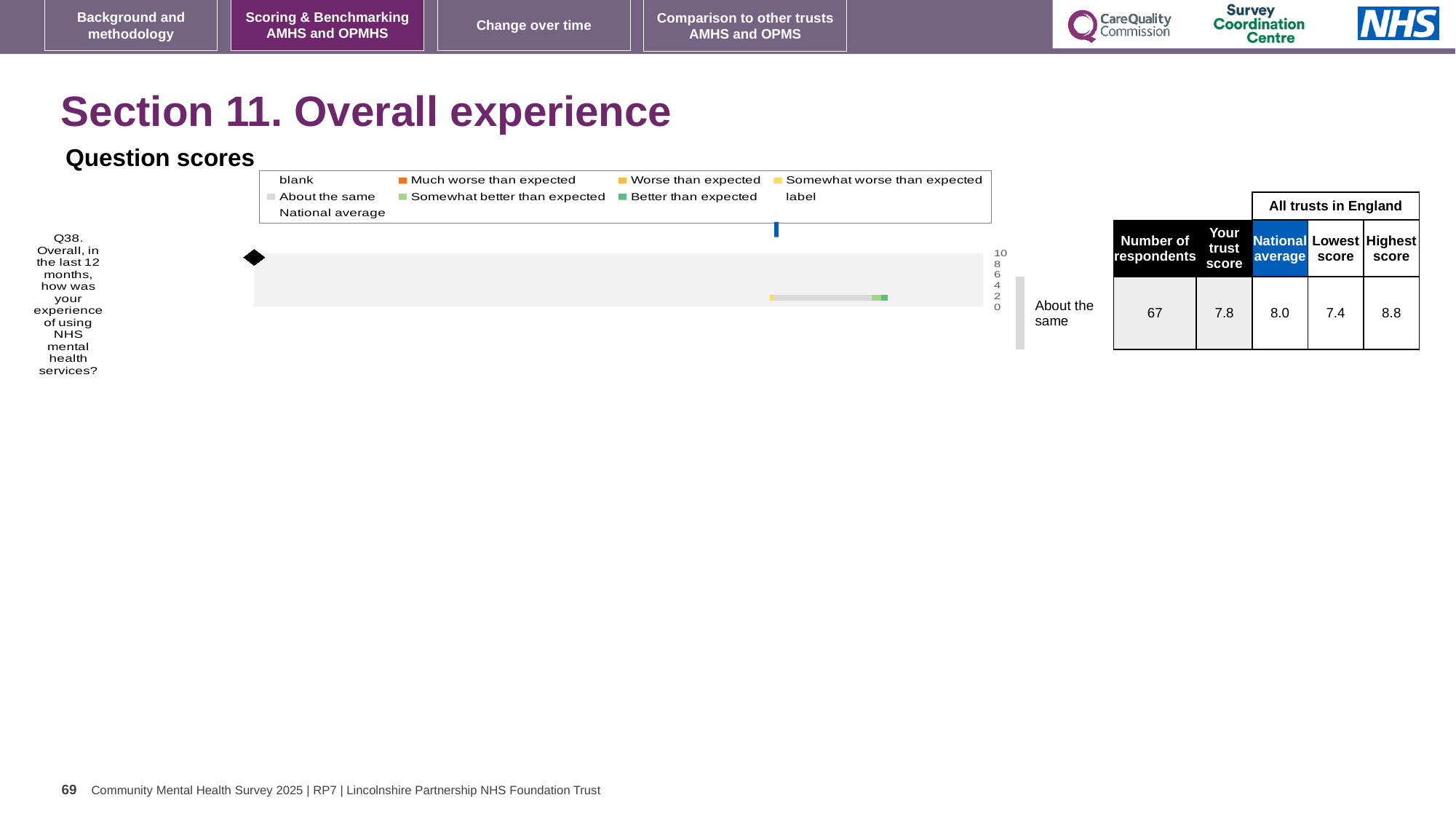
In the table beside the chart, what is the lowest score among all trusts in England for Q38? 7.4 In the table beside the chart, how many respondents answered Q38? 67 What kind of chart is shown under 'Question scores'? bar chart In the table beside the chart, what is the national average score for Q38? 8.0 Which question number is plotted in the Question scores chart? Q38 How many survey questions are plotted in the Question scores chart? 1 What is the difference between the highest score (8.8) and the lowest score (7.4) for Q38? 1.4 How many entries does the legend of the Question scores chart list? 9 What is the highest tick value shown on the axis of the Question scores chart? 10 In the table beside the chart, what is the trust score for Q38? 7.8 What benchmark category is shown next to the bar for Q38? About the same For Q38, which is larger: the trust score or the national average? national average